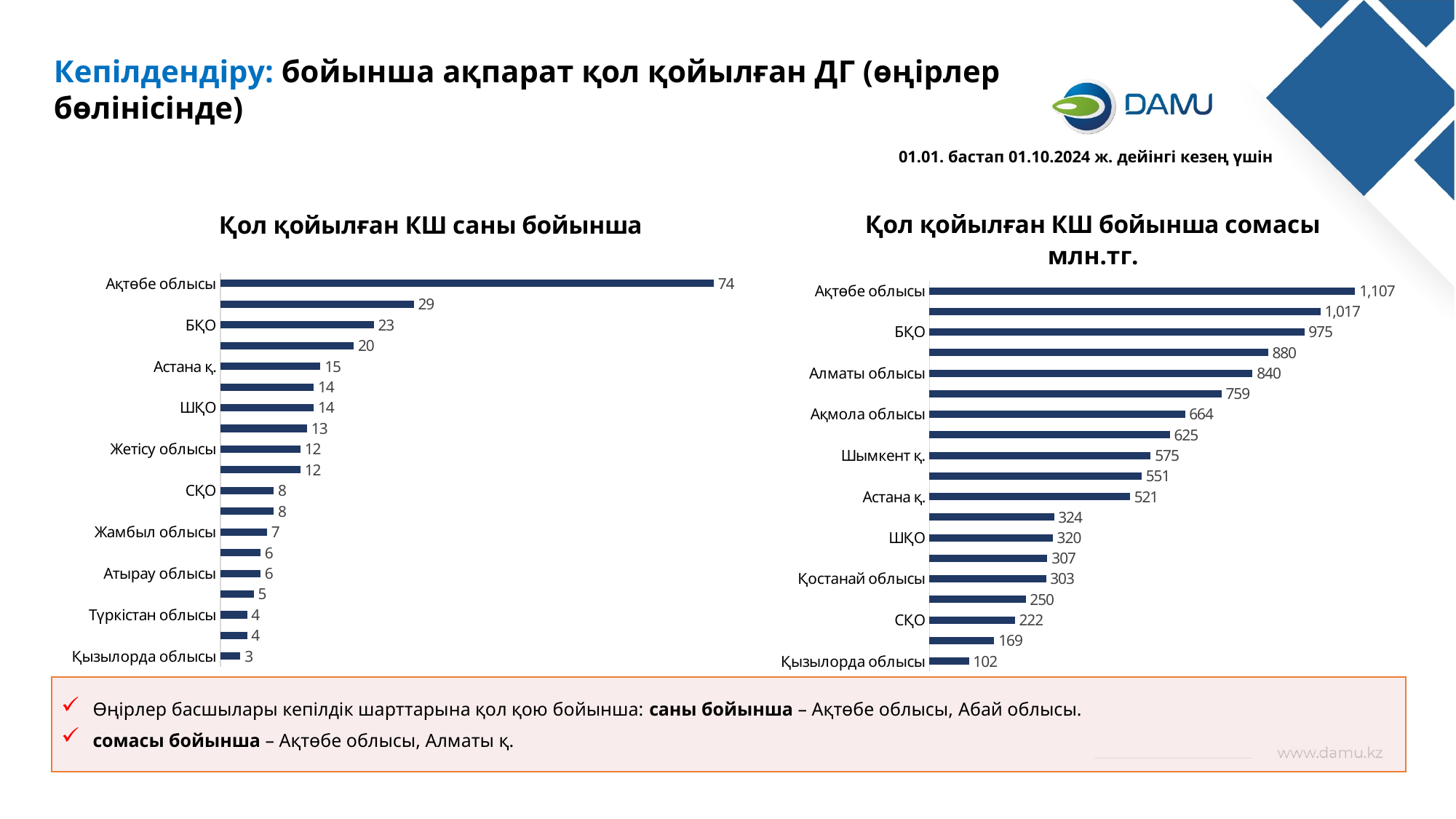
In the chart 'Қол қойылған КШ саны бойынша', what is the difference between Ақтөбе облысы and БҚО? 51 In the chart 'Қол қойылған КШ саны бойынша', which region has the lowest value? Қызылорда облысы In the chart 'Қол қойылған КШ саны бойынша', which is larger: Астана қ. or СҚО? Астана қ. How many bars are plotted in the chart 'Қол қойылған КШ бойынша сомасы млн.тг.'? 19 In the chart 'Қол қойылған КШ бойынша сомасы млн.тг.', what is the value for Шымкент қ.? 575 In the chart 'Қол қойылған КШ бойынша сомасы млн.тг.', which region has the highest value? Ақтөбе облысы In the chart 'Қол қойылған КШ бойынша сомасы млн.тг.', what is the difference between БҚО and Алматы облысы? 135 In the chart 'Қол қойылған КШ саны бойынша', what is the value for Ақтөбе облысы? 74 In the chart 'Қол қойылған КШ саны бойынша', what is the value for Жамбыл облысы? 7 In the chart 'Қол қойылған КШ бойынша сомасы млн.тг.', what is the value for Ақтөбе облысы? 1,107 In the chart 'Қол қойылған КШ бойынша сомасы млн.тг.', which is larger: Қостанай облысы or СҚО? Қостанай облысы What type of chart is 'Қол қойылған КШ саны бойынша'? Bar chart